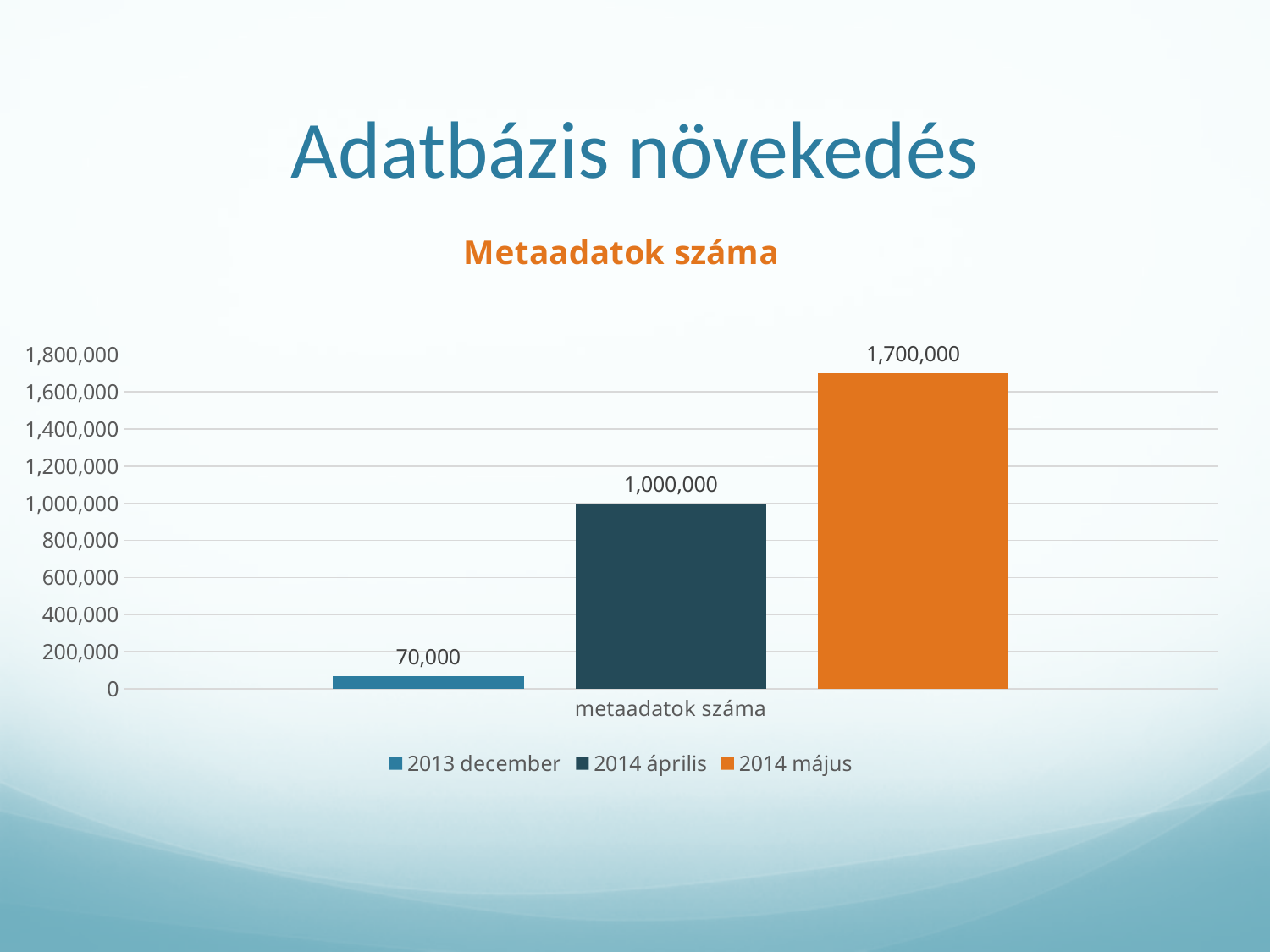
What kind of chart is shown on the slide? bar chart What is the title of the chart? Metaadatok száma Is the value for 2014 május greater or less than 1,600,000? greater What is the value for 2014 április? 1,000,000 Which series has the highest value? 2014 május How many series does the legend list? 3 What is the difference between the values for 2014 május and 2014 április? 700,000 Which is larger, the value for 2014 április or the value for 2013 december? 2014 április What is the difference between the values for 2014 április and 2013 december? 930,000 What is the value for 2014 május? 1,700,000 What is the value for 2013 december? 70,000 Which series has the lowest value? 2013 december